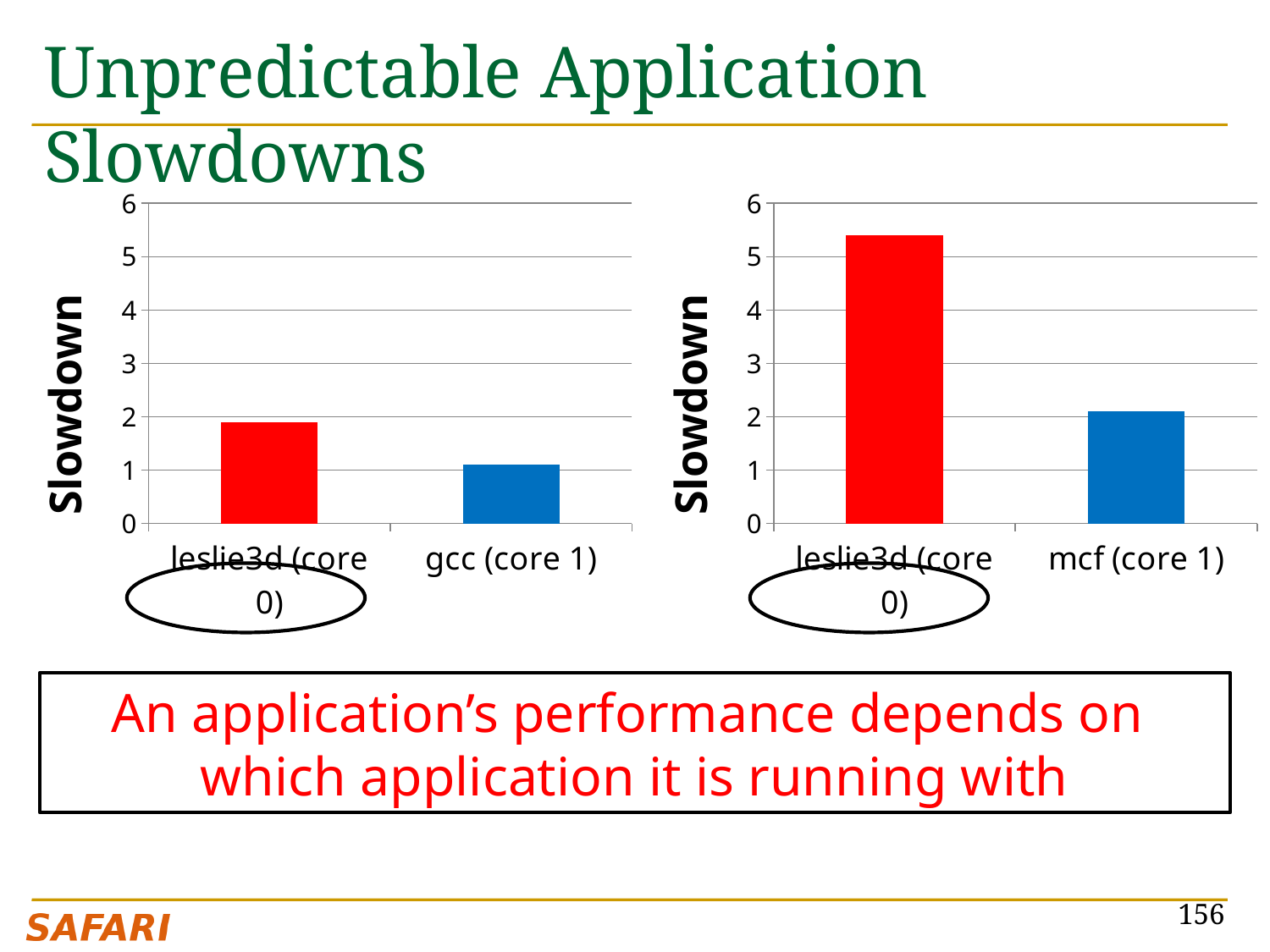
How many categories does the left chart show? 2 What is the y-axis label on the right chart? Slowdown In the right chart, is the slowdown for mcf (core 1) greater or less than 3? less What is the highest value shown on the y-axis of the left chart? 6 In the right chart, is the slowdown for leslie3d (core 0) greater or less than 5? greater In the left chart, which category has the higher slowdown? leslie3d (core 0) Is the slowdown for leslie3d (core 0) larger in the left chart or the right chart? right chart What kind of chart is the left chart on the slide? bar chart In the right chart, which category has the lower slowdown? mcf (core 1) How many categories does the right chart show? 2 In the left chart, is the slowdown for gcc (core 1) greater or less than 2? less